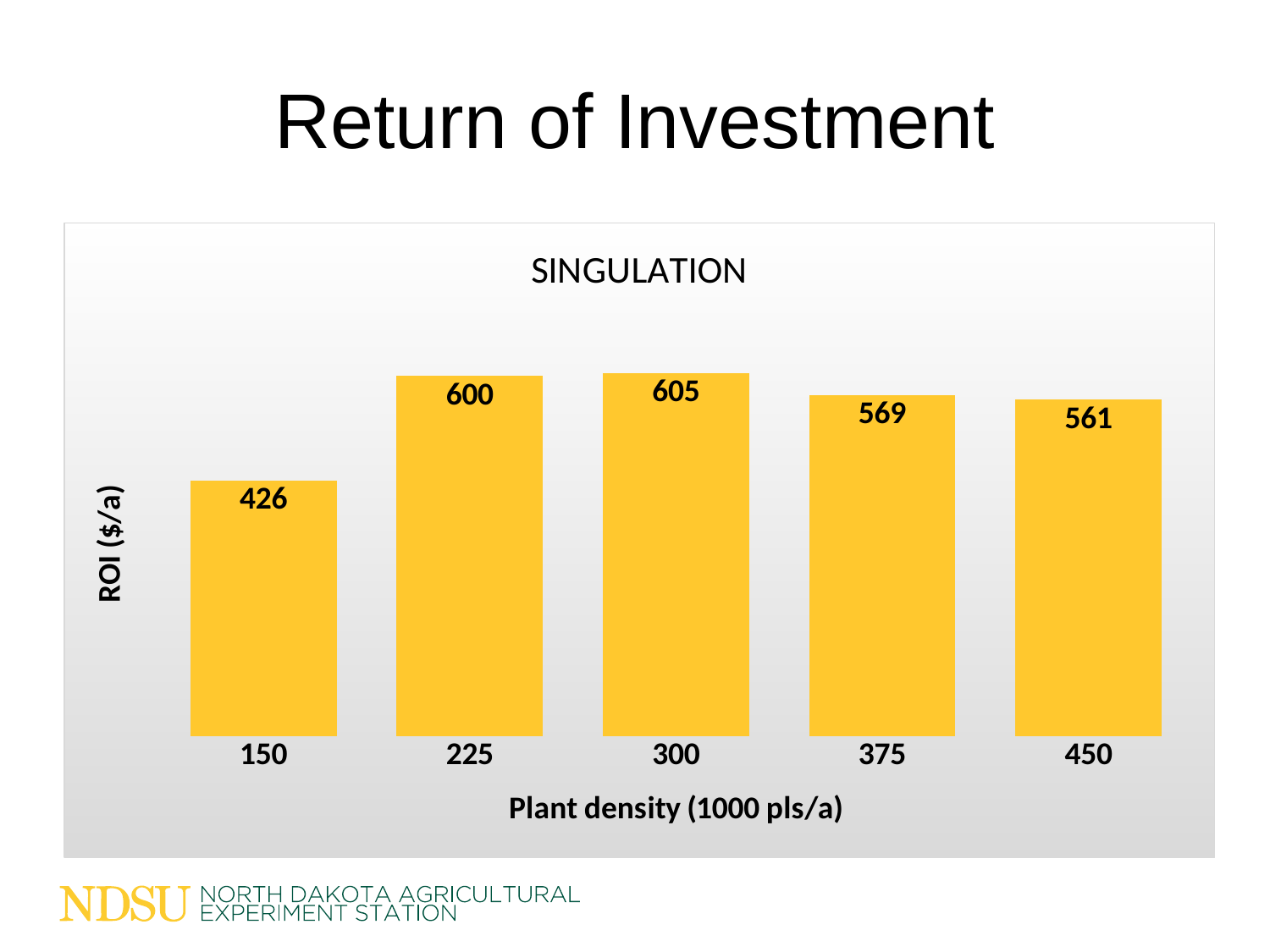
What is the title of the chart? SINGULATION Does the ROI rise or fall from plant density 300 to plant density 450? Fall What is the difference in ROI between plant densities 375 and 450? 8 What type of chart is shown on the slide? Bar chart What is the ROI for a plant density of 150 (1000 pls/a)? 426 What is the difference in ROI between plant densities 225 and 150? 174 What is the ROI for a plant density of 450 (1000 pls/a)? 561 How many plant density categories are shown in the chart? 5 Which has a higher ROI: plant density 225 or plant density 375? 225 What is the ROI for a plant density of 300 (1000 pls/a)? 605 What is the label of the x axis? Plant density (1000 pls/a) Which plant density has the lowest ROI? 150